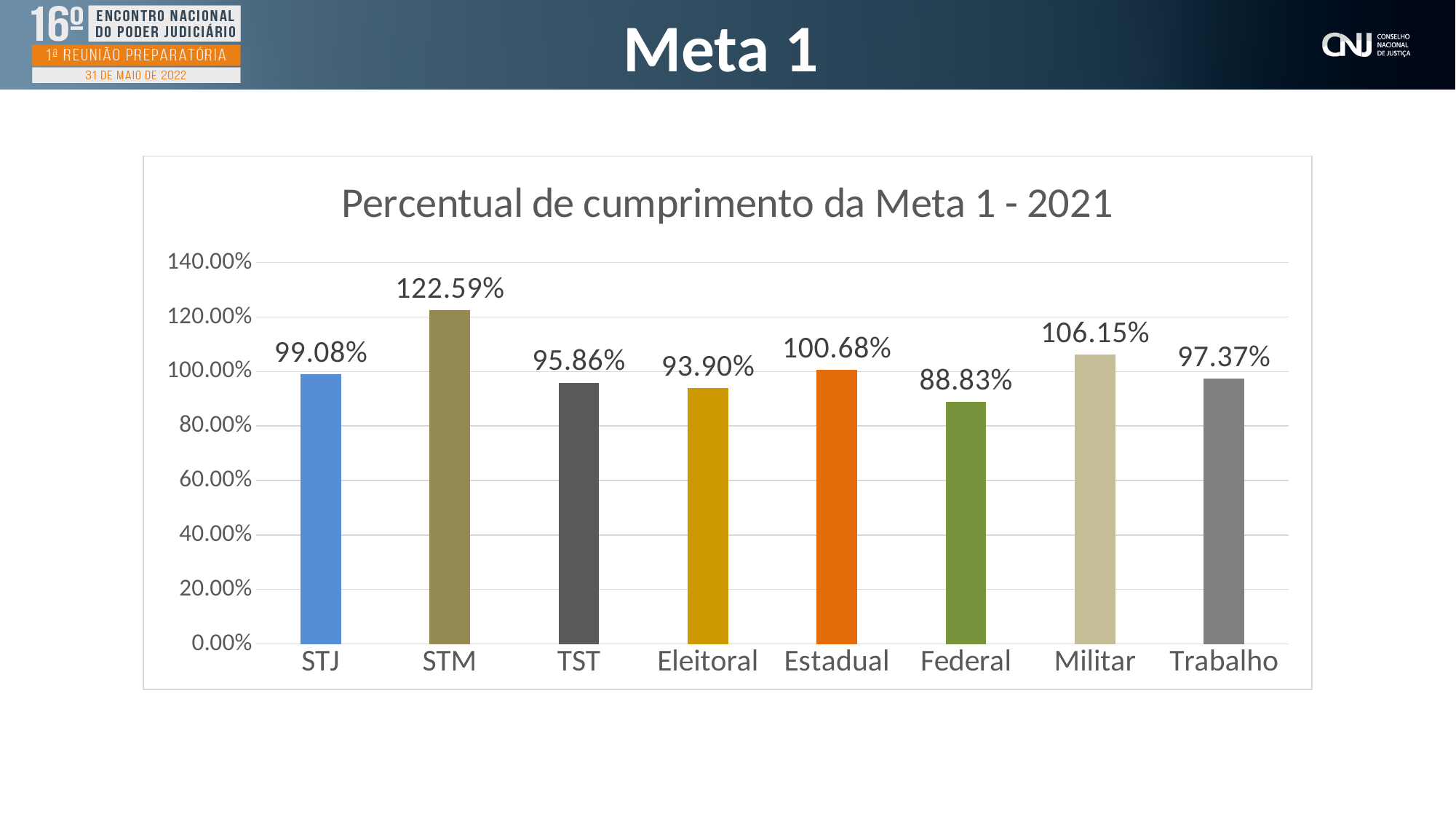
Which is larger, the value for STJ or the value for Trabalho? STJ What is the title of the chart? Percentual de cumprimento da Meta 1 - 2021 What is the value for Federal? 88.83% How many categories are shown on the x axis? 8 Which category has the lowest value? Federal What is the value for STM? 122.59% Which category has the highest value? STM What is the difference between the values for Estadual and TST? 4.82% Is the value for Eleitoral greater or less than 100.00%? less What is the value for Militar? 106.15% What kind of chart is shown? bar chart What is the difference between the values for STM and Federal? 33.76%